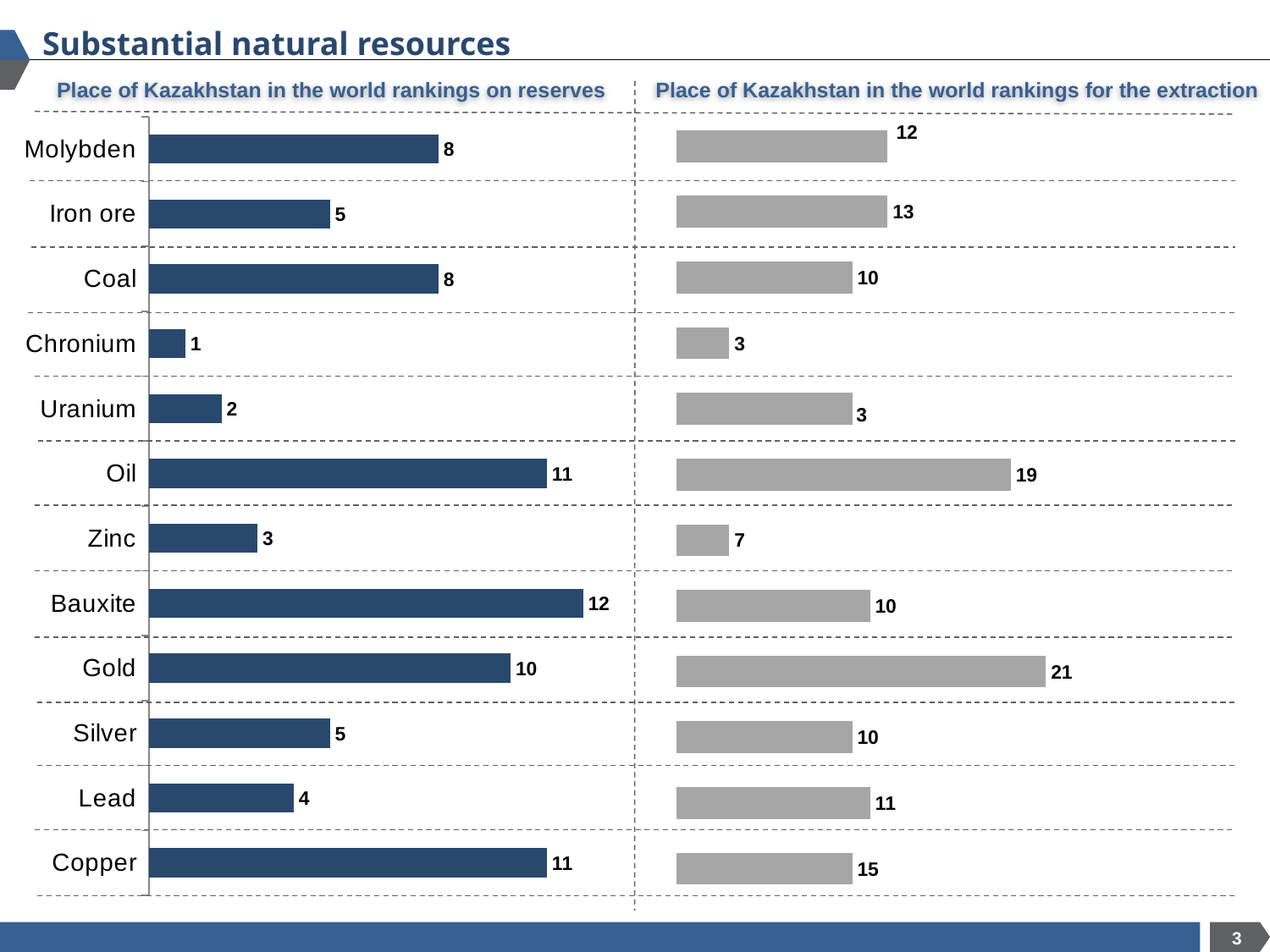
In the chart 'Place of Kazakhstan in the world rankings on reserves', which category has the lowest value? Chronium In the chart 'Place of Kazakhstan in the world rankings for the extraction', which is larger, the value for Copper or the value for Lead? Copper In the chart 'Place of Kazakhstan in the world rankings on reserves', what is the value for Chronium? 1 In the chart 'Place of Kazakhstan in the world rankings on reserves', which category has the highest value? Bauxite How many categories are shown in the chart 'Place of Kazakhstan in the world rankings on reserves'? 12 In the chart 'Place of Kazakhstan in the world rankings for the extraction', which category has the highest value? Gold In the chart 'Place of Kazakhstan in the world rankings for the extraction', what is the difference between the values for Oil and Zinc? 12 In the chart 'Place of Kazakhstan in the world rankings for the extraction', what is the value for Gold? 21 What kind of chart is 'Place of Kazakhstan in the world rankings for the extraction'? Bar chart What is the title of the left chart on the slide? Place of Kazakhstan in the world rankings on reserves In the chart 'Place of Kazakhstan in the world rankings on reserves', what is the value for Oil? 11 In the chart 'Place of Kazakhstan in the world rankings on reserves', which is larger, the value for Gold or the value for Silver? Gold